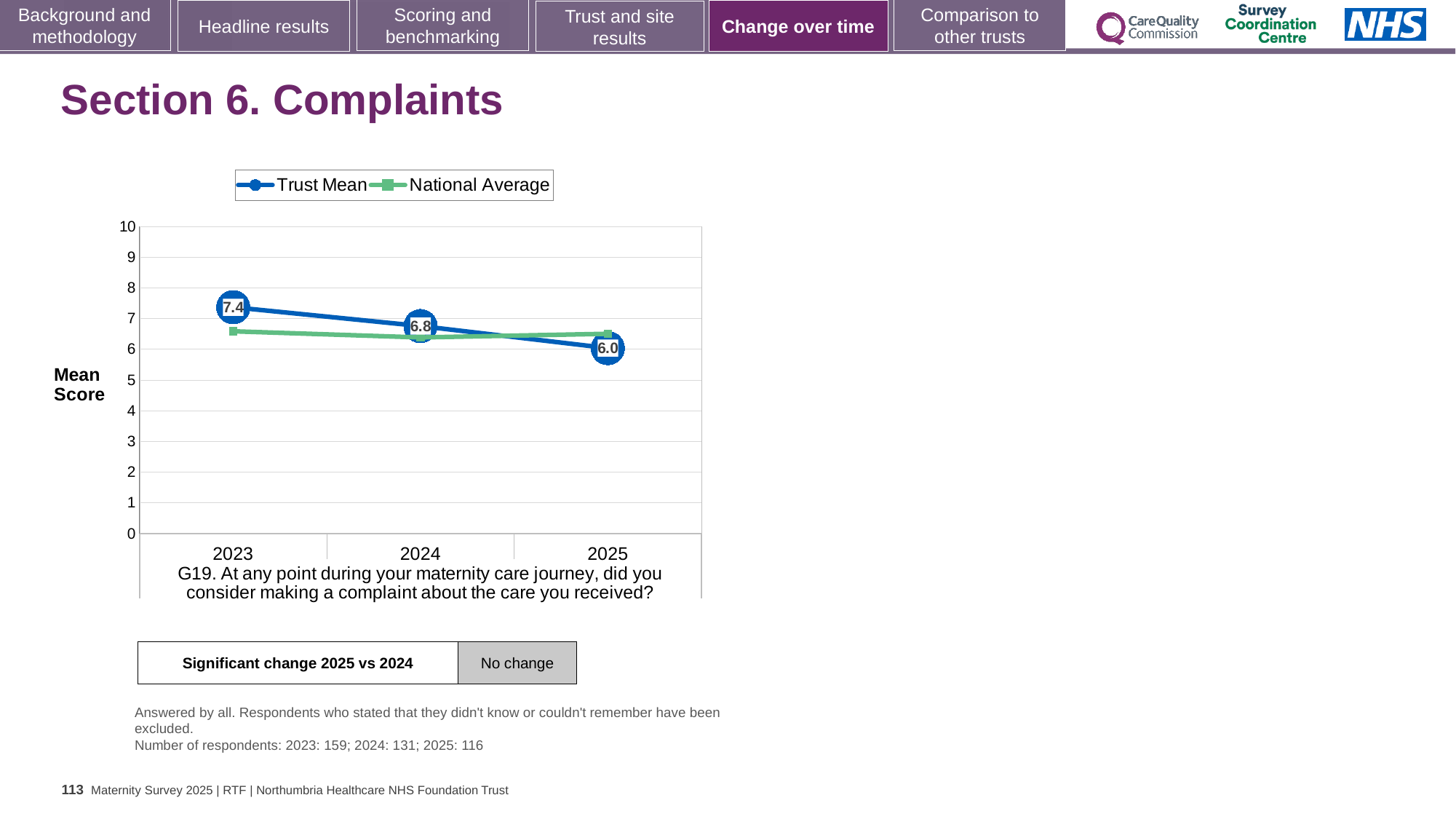
How many series does the legend list? 2 What is the difference between the Trust Mean in 2023 and in 2025? 1.4 What is the Trust Mean value for 2025? 6.0 What kind of chart is shown on the slide? Line chart In which year is the Trust Mean lowest? 2025 How many years are plotted on the x axis? 3 Is the National Average value for 2025 greater or less than 6? greater In which year is the Trust Mean highest? 2023 What is the Trust Mean value for 2024? 6.8 Is the National Average value for 2023 greater or less than 7? less Which is larger in 2023, the Trust Mean or the National Average? Trust Mean What is the Trust Mean value for 2023? 7.4